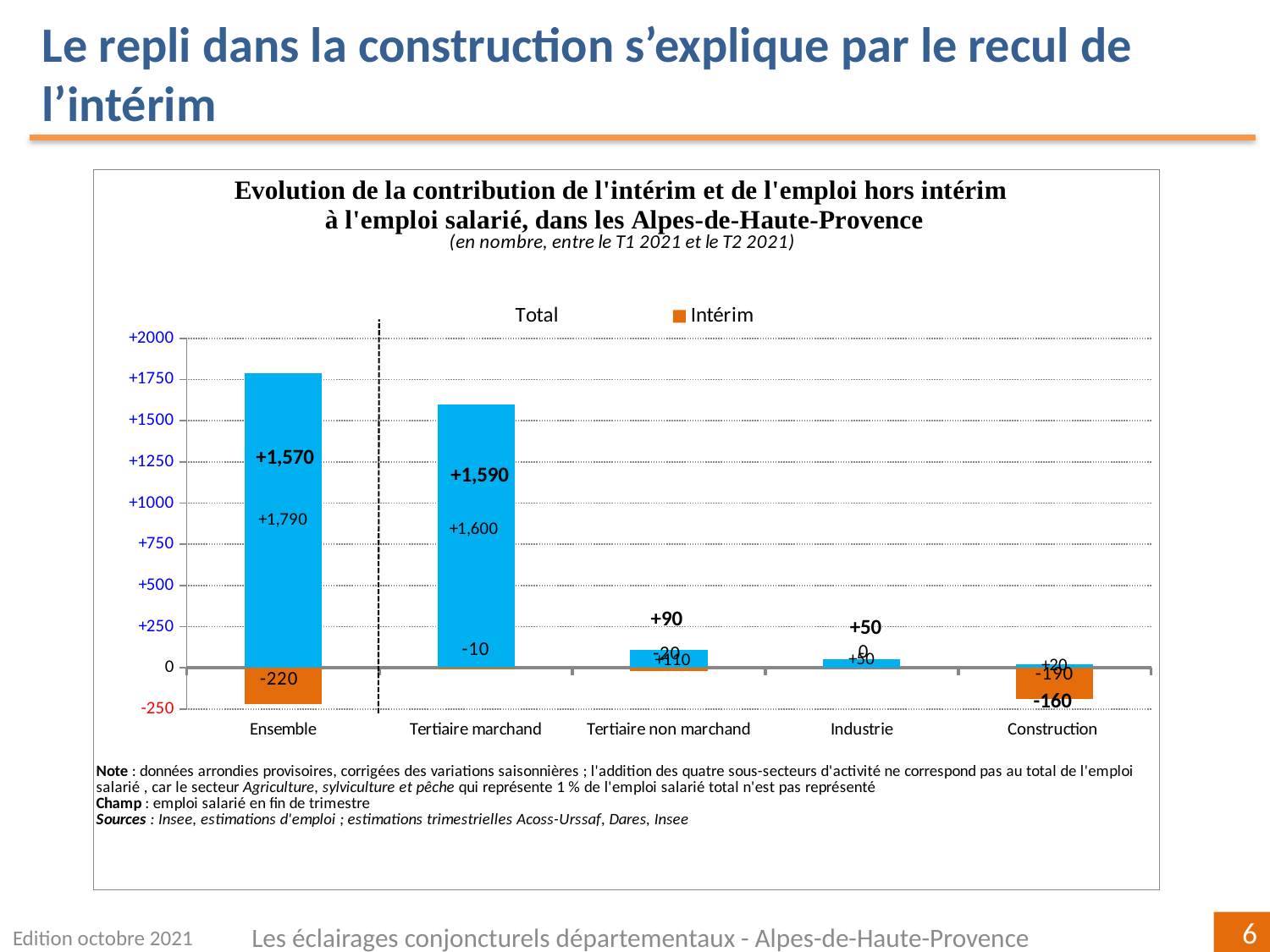
Which colour represents the Intérim series in the legend? orange What is the total (bold label) for Industrie? +50 Which category has the highest total (bold label)? Tertiaire marchand What is the total (bold label) for Construction? -160 What is the Intérim value for Construction? -190 What is the total (bold label) for Tertiaire marchand? +1,590 What kind of chart is shown on the slide? bar chart What is the Intérim value for Ensemble? -220 What is the difference between the total for Ensemble (+1,570) and the total for Construction (-160)? 1,730 Which has the larger Intérim value, Ensemble or Construction? Construction Which category has the lowest total (bold label)? Construction How many sector categories are shown along the x axis of the chart? 5